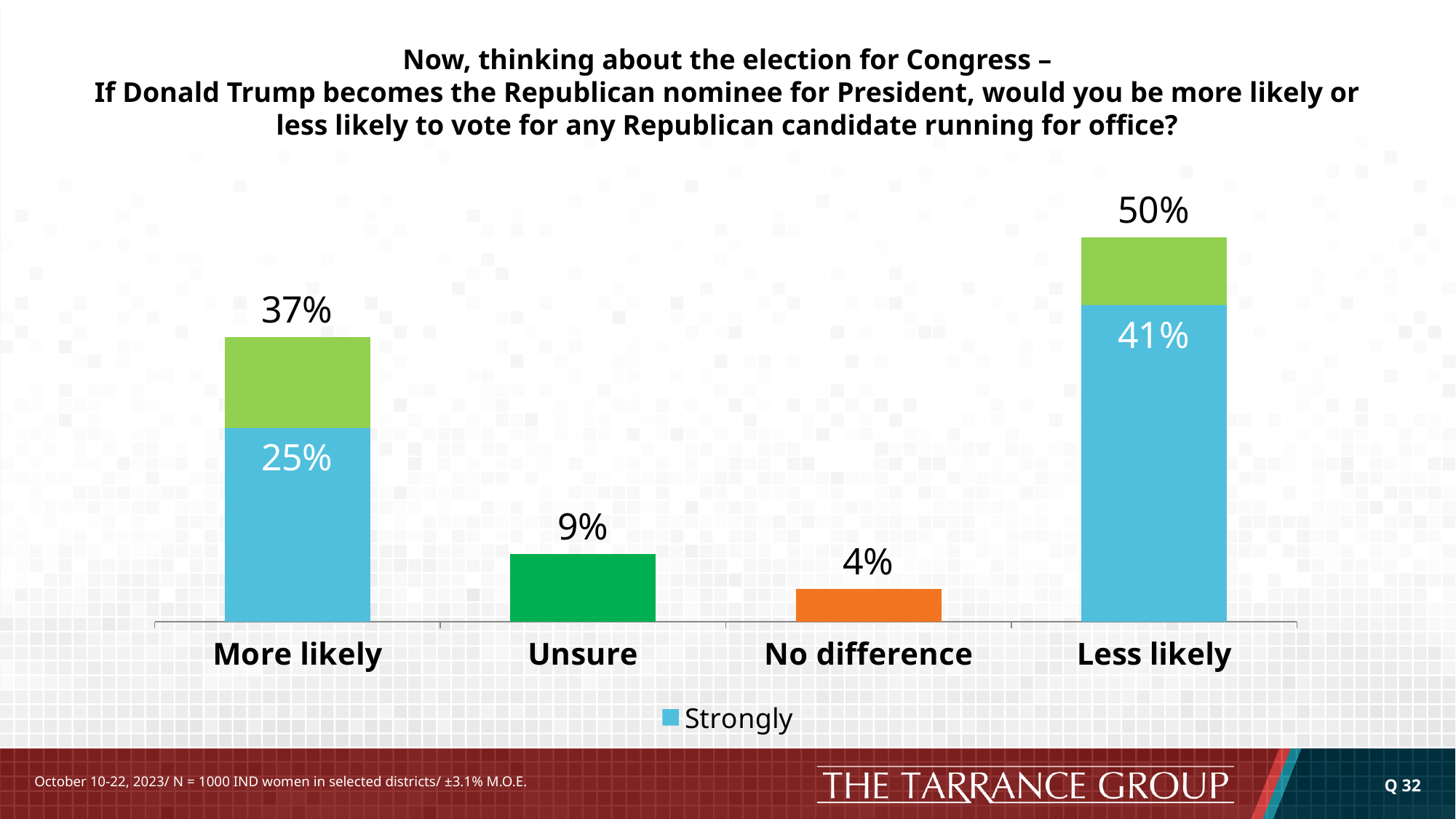
What is the difference between the total for "Less likely" and the total for "More likely"? 13% How many categories are shown on the x axis? 4 Which category has the highest total value? Less likely What entry does the legend list? Strongly What value is shown for "Unsure"? 9% Which category has the lowest value? No difference What is the total value shown for the "Less likely" bar? 50% What is the total value shown for the "More likely" bar? 37% Which is larger, the "Strongly" portion of "Less likely" or the "Strongly" portion of "More likely"? Less likely What kind of chart is shown on the slide? Bar chart What is the "Strongly" portion of the "Less likely" bar? 41% What is the "Strongly" portion of the "More likely" bar? 25%